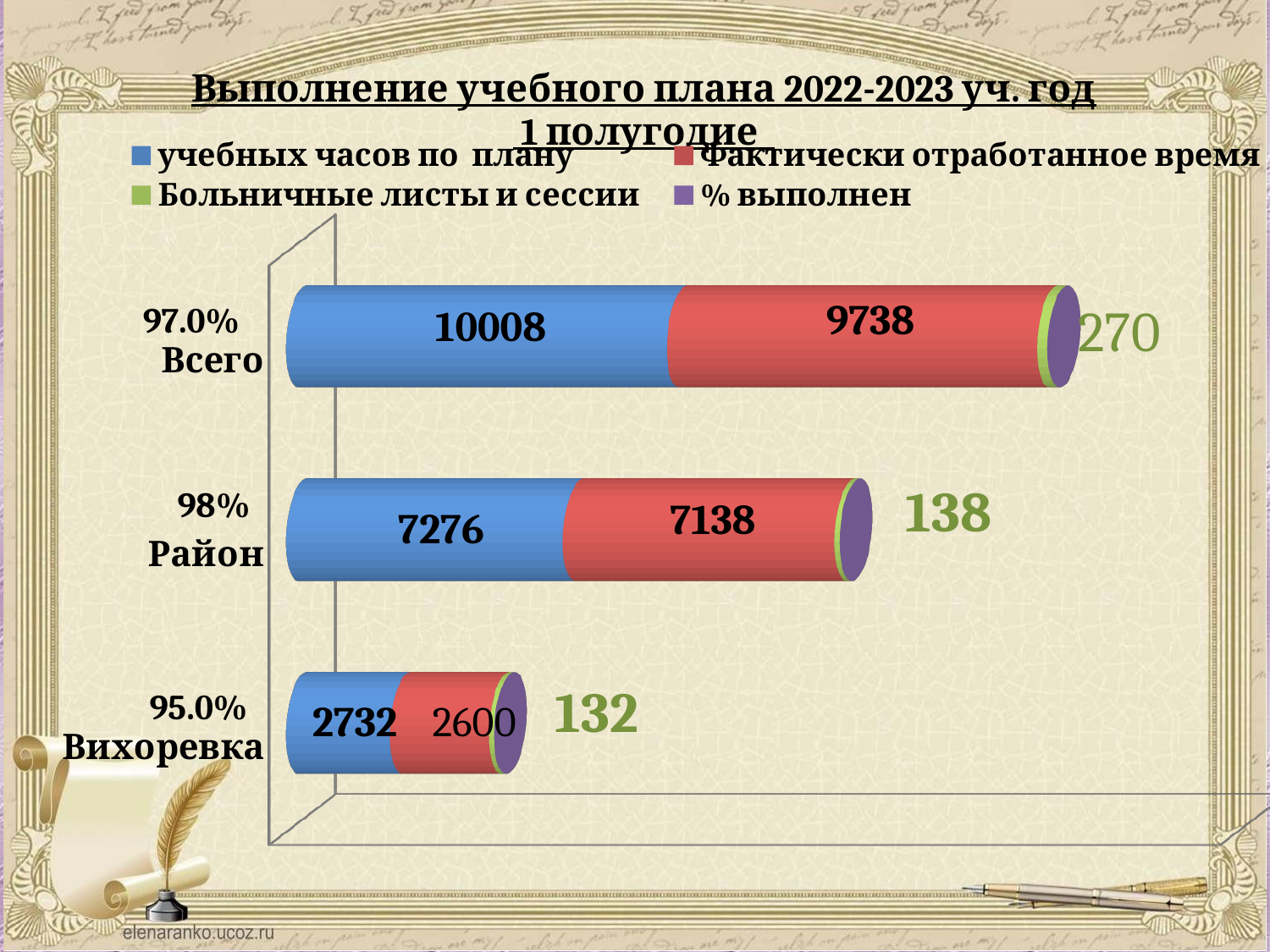
What is the value of 'Фактически отработанное время' for Вихоревка? 2600 What is the value of 'Больничные листы и сессии' for Вихоревка? 132 How many categories does the chart show? 3 Which category has the lowest value for 'Фактически отработанное время'? Вихоревка Which category has the highest value for 'учебных часов по плану'? Всего What is the value of 'Фактически отработанное время' for Район? 7138 What kind of chart is shown on the slide? bar chart What is the value of 'учебных часов по плану' for Всего? 10008 What is the difference between 'учебных часов по плану' and 'Фактически отработанное время' for Всего? 270 How many series does the legend list? 4 Which is larger: 'Больничные листы и сессии' for Район or for Вихоревка? Район What percentage is shown next to the category label Район? 98%